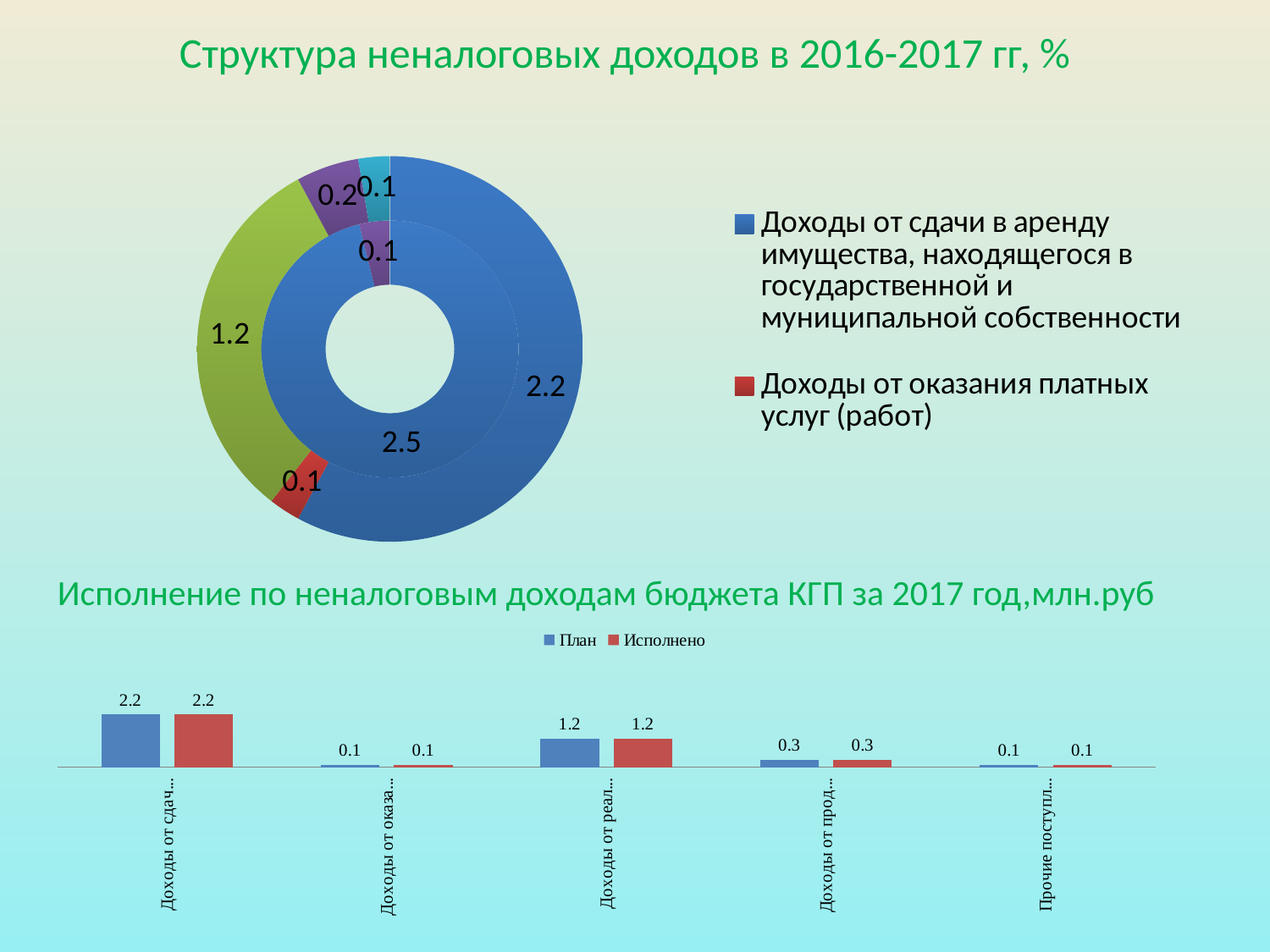
In the bottom bar chart, what is the difference between the План value for 'Доходы от сдач...' and the План value for 'Доходы от реал...'? 1.0 In the top doughnut chart, what value is labelled on the red segment (Доходы от оказания платных услуг (работ)) of the outer ring? 0.1 In the top doughnut chart, what colour does the legend assign to 'Доходы от оказания платных услуг (работ)'? Red What kind of chart is the top chart titled 'Структура неналоговых доходов в 2016-2017 гг, %'? Doughnut chart In the bottom bar chart, which category has the highest План value? Доходы от сдач... In the bottom bar chart, which has the larger Исполнено value: 'Доходы от реал...' or 'Доходы от прод...'? Доходы от реал... In the bottom bar chart, how many categories are shown on the x axis? 5 In the bottom bar chart, what is the Исполнено value for the category labelled 'Доходы от прод...'? 0.3 What kind of chart is the bottom chart titled 'Исполнение по неналоговым доходам бюджета КГП за 2017 год,млн.руб'? Bar chart In the top doughnut chart, what is the largest value labelled on the inner ring? 2.5 In the bottom bar chart, how many series does the legend list? 2 In the bottom bar chart, what is the План value for the first category (Доходы от сдач...)? 2.2